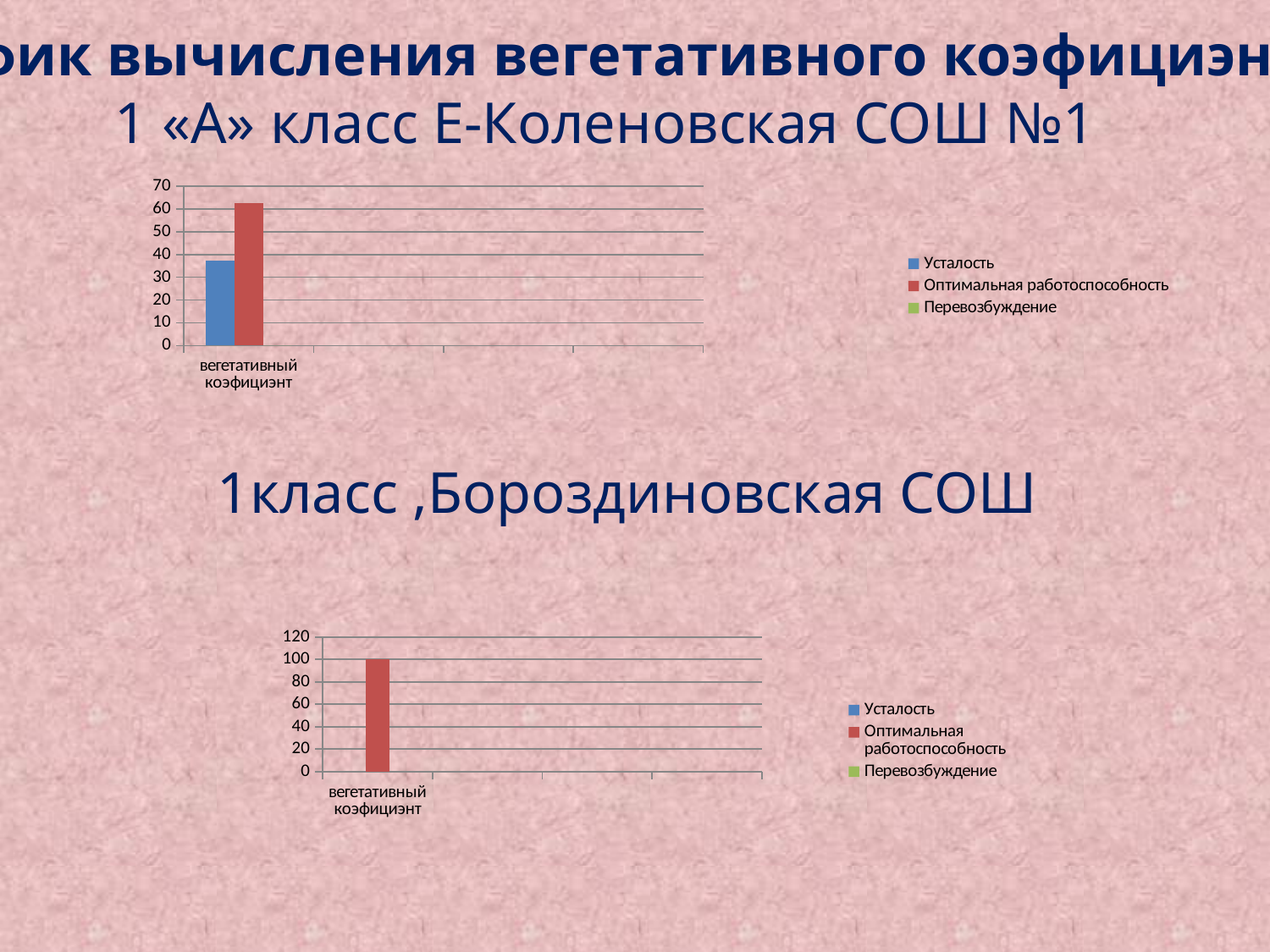
In the bottom chart (1класс, Бороздиновская СОШ), is the value for Оптимальная работоспособность greater or less than 80? greater In the top chart (1 «А» класс Е-Коленовская СОШ №1), is the value for Усталость greater or less than 50? less What is the third legend entry in the bottom chart (1класс, Бороздиновская СОШ)? Перевозбуждение In the top chart (1 «А» класс Е-Коленовская СОШ №1), is the value for Усталость greater or less than 20? greater In the top chart (1 «А» класс Е-Коленовская СОШ №1), which is larger: Усталость or Оптимальная работоспособность? Оптимальная работоспособность What is the highest value shown on the y axis of the bottom chart (1класс, Бороздиновская СОШ)? 120 What kind of chart is the top chart (1 «А» класс Е-Коленовская СОШ №1)? bar chart How many series does the legend of the bottom chart (1класс, Бороздиновская СОШ) list? 3 How many series does the legend of the top chart (1 «А» класс Е-Коленовская СОШ №1) list? 3 How many categories are shown on the x axis of the bottom chart (1класс, Бороздиновская СОШ)? 1 In the top chart (1 «А» класс Е-Коленовская СОШ №1), which series has the highest bar? Оптимальная работоспособность